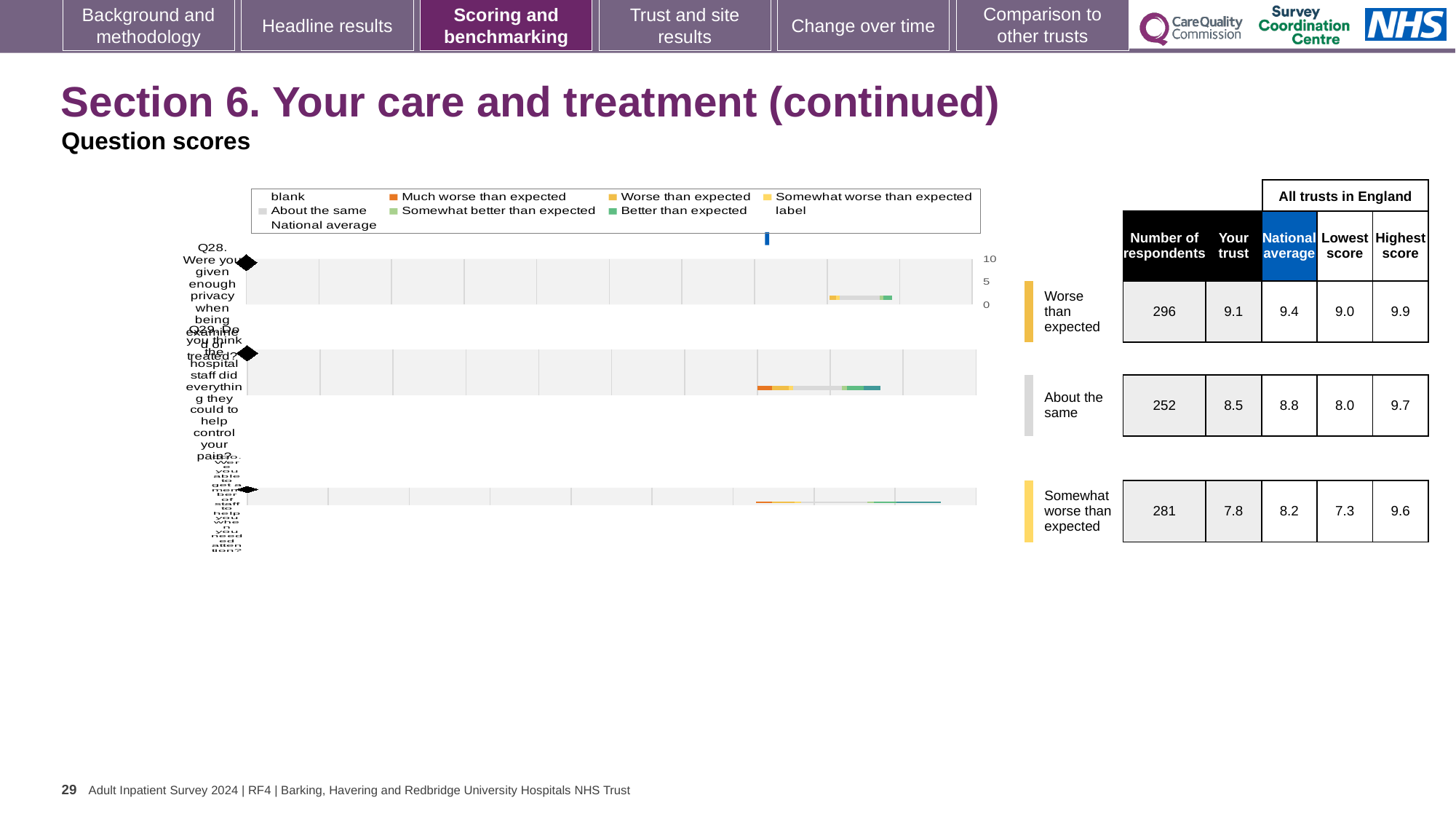
In the table, what is the difference between the national average and the 'Your trust' score for the row labelled 'Worse than expected'? 0.3 What kind of chart is shown on the slide? bar chart In the table, what is the highest score for the row labelled 'Worse than expected'? 9.9 Which table row has the largest number of respondents? Worse than expected What is the highest value shown on the chart's axis? 10 Which legend entry is shown in orange on the chart? Much worse than expected In the table, what is the national average for the row labelled 'Somewhat worse than expected'? 8.2 In the table, is the 'Your trust' score or the national average larger for the row labelled 'About the same'? National average How many survey questions (categories) are plotted on the chart? 3 Which table row has the lowest 'Your trust' score? Somewhat worse than expected In the table, what is the 'Your trust' score for the row labelled 'About the same'? 8.5 In the table, how many respondents are listed for the row labelled 'Worse than expected'? 296